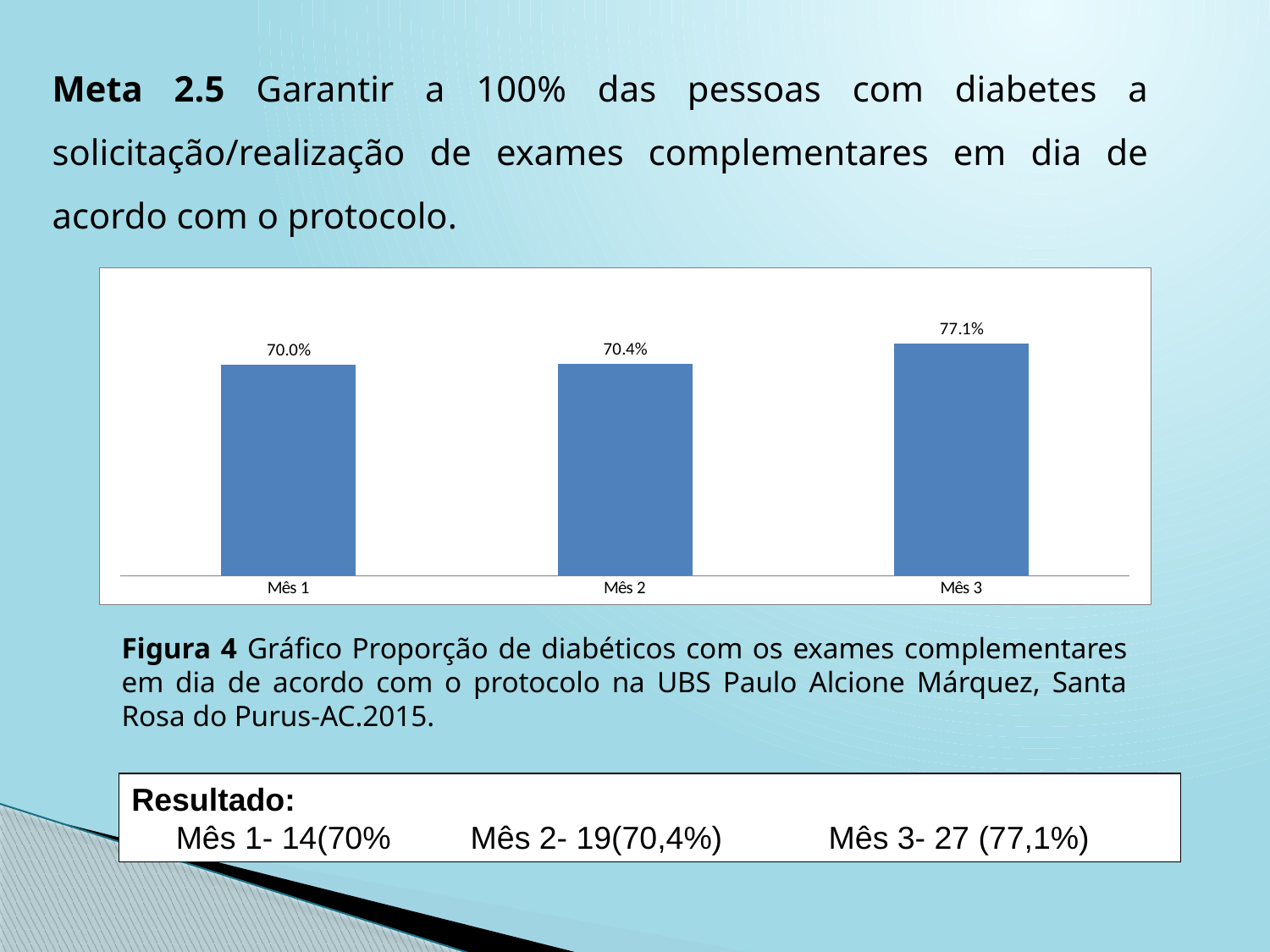
What is the value for Mês 3? 77.1% What figure number is given in the caption below the chart? Figura 4 Which month has the highest value? Mês 3 Do the values rise or fall from Mês 1 to Mês 3? Rise What kind of chart is shown on the slide? Bar chart What is the difference between the values for Mês 3 and Mês 2? 6.7 percentage points What is the difference between the values for Mês 3 and Mês 1? 7.1 percentage points Which is larger, the value for Mês 3 or the value for Mês 1? Mês 3 Which month has the lowest value? Mês 1 What is the value for Mês 1? 70.0% How many months are shown on the chart? 3 What is the value for Mês 2? 70.4%